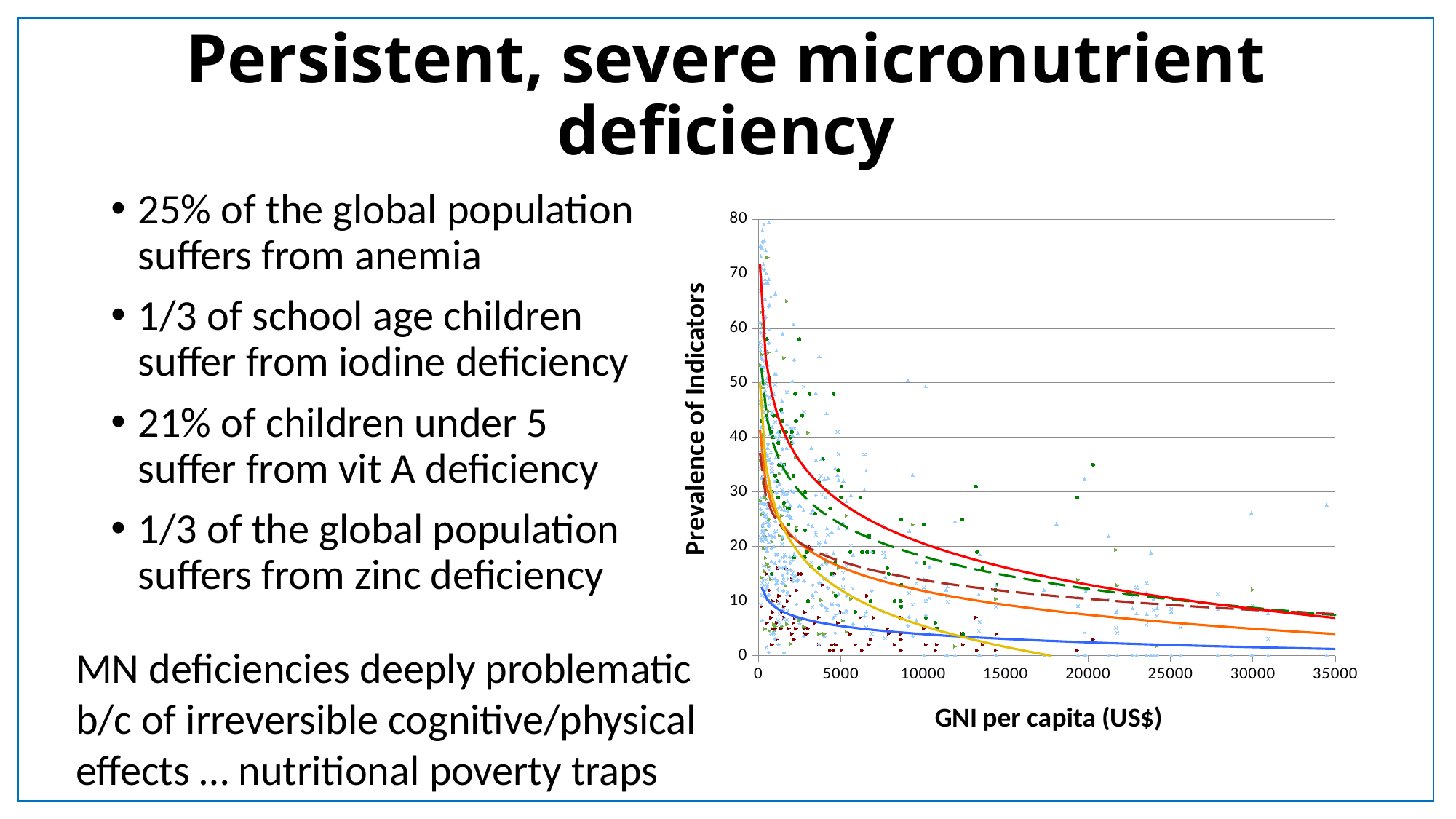
What is the highest value shown on the horizontal axis of the chart? 35000 What kind of chart is shown on the slide? scatter chart Do the fitted trend lines in the chart rise or fall as GNI per capita increases? fall What is the highest value shown on the vertical axis of the chart? 80 Is the prevalence of indicators generally greater or less at low GNI per capita compared with high GNI per capita? greater What is the label of the vertical axis of the chart? Prevalence of Indicators What is the label of the horizontal axis of the chart? GNI per capita (US$)